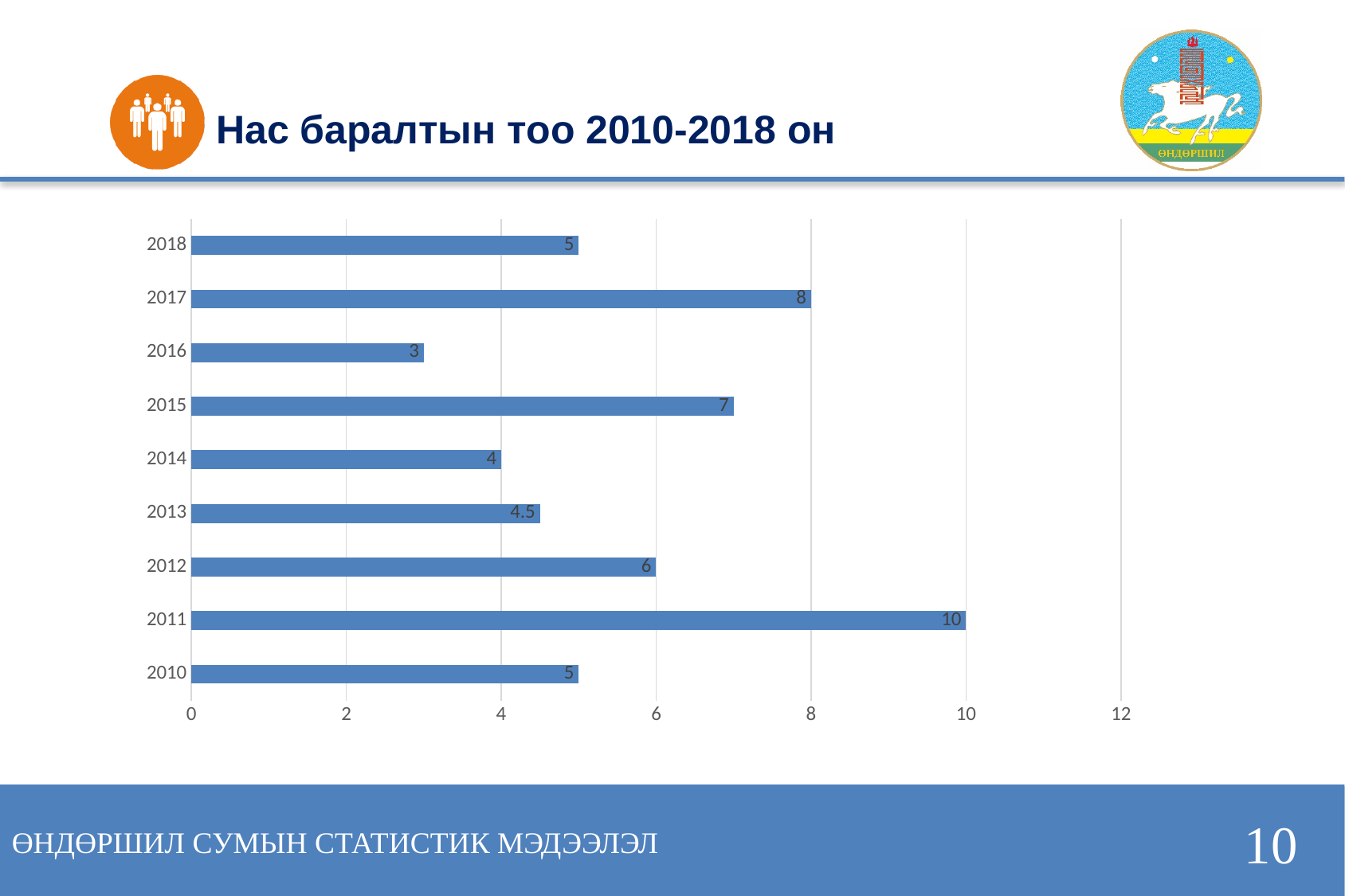
What kind of chart is shown on the slide? bar chart What is the value for 2016? 3 What is the title of the slide? Нас баралтын тоо 2010-2018 он Which year has the highest value? 2011 Which is larger, the value for 2014 or the value for 2013? 2013 What is the value for 2013? 4.5 What is the value for 2011? 10 Which year has the lowest value? 2016 What is the difference between the values for 2017 and 2015? 1 Is the value for 2017 greater or less than 6? greater How many years are shown in the chart? 9 What is the difference between the values for 2011 and 2012? 4